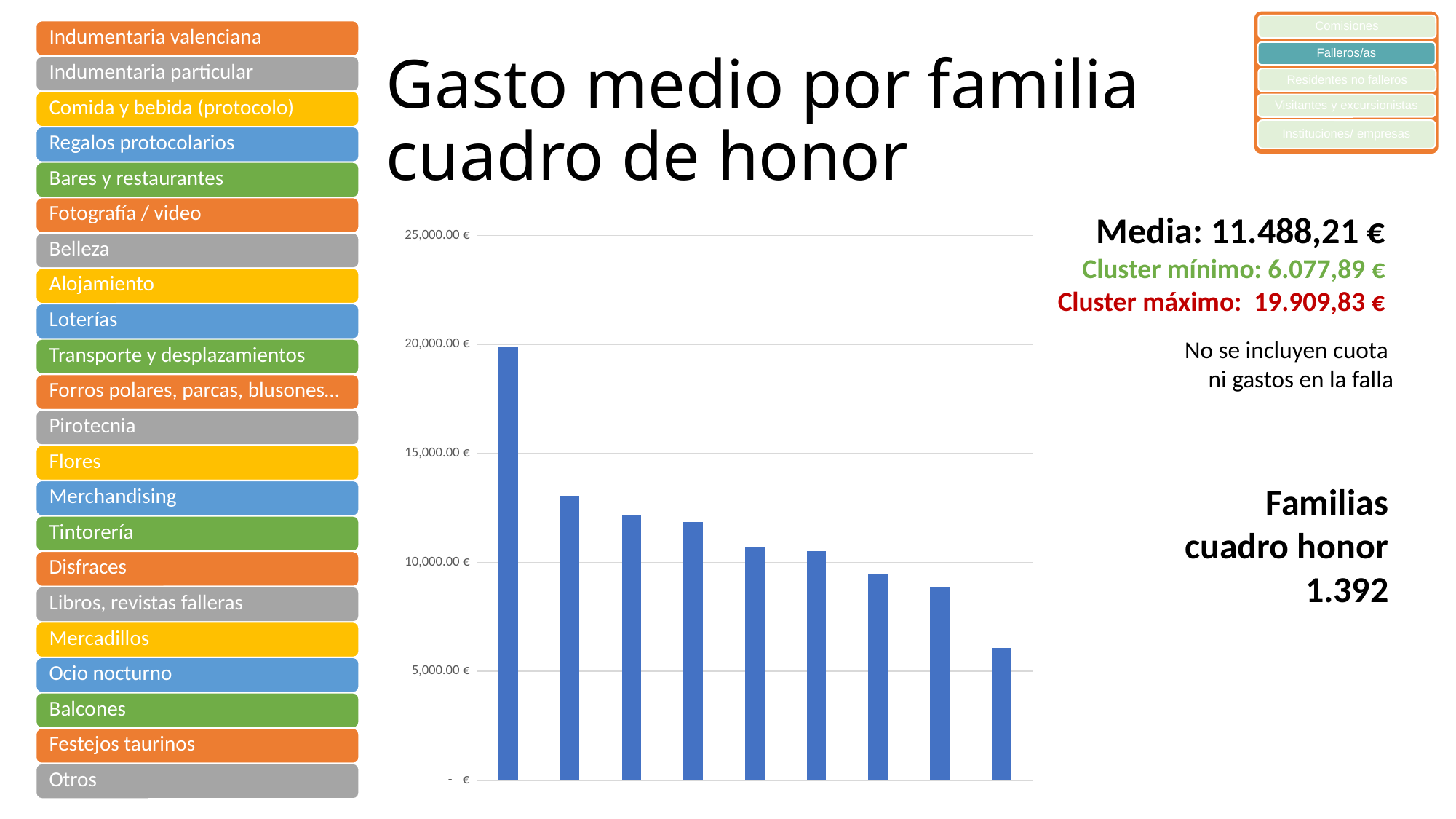
Is the value of the rightmost bar greater or less than 5,000.00 €? greater Is the value of the leftmost bar greater or less than 15,000.00 €? greater Is the value of the second bar from the left greater or less than 15,000.00 €? less Do the bar values rise or fall from left to right across the chart? fall What is the highest value shown on the chart's vertical axis? 25,000.00 € How many bars are plotted in the chart? 9 Which bar is the shortest in the chart? the rightmost (last) bar Which bar is the tallest in the chart? the leftmost (first) bar Which is larger, the leftmost bar or the second bar from the left? the leftmost bar What kind of chart is shown on the slide? bar chart